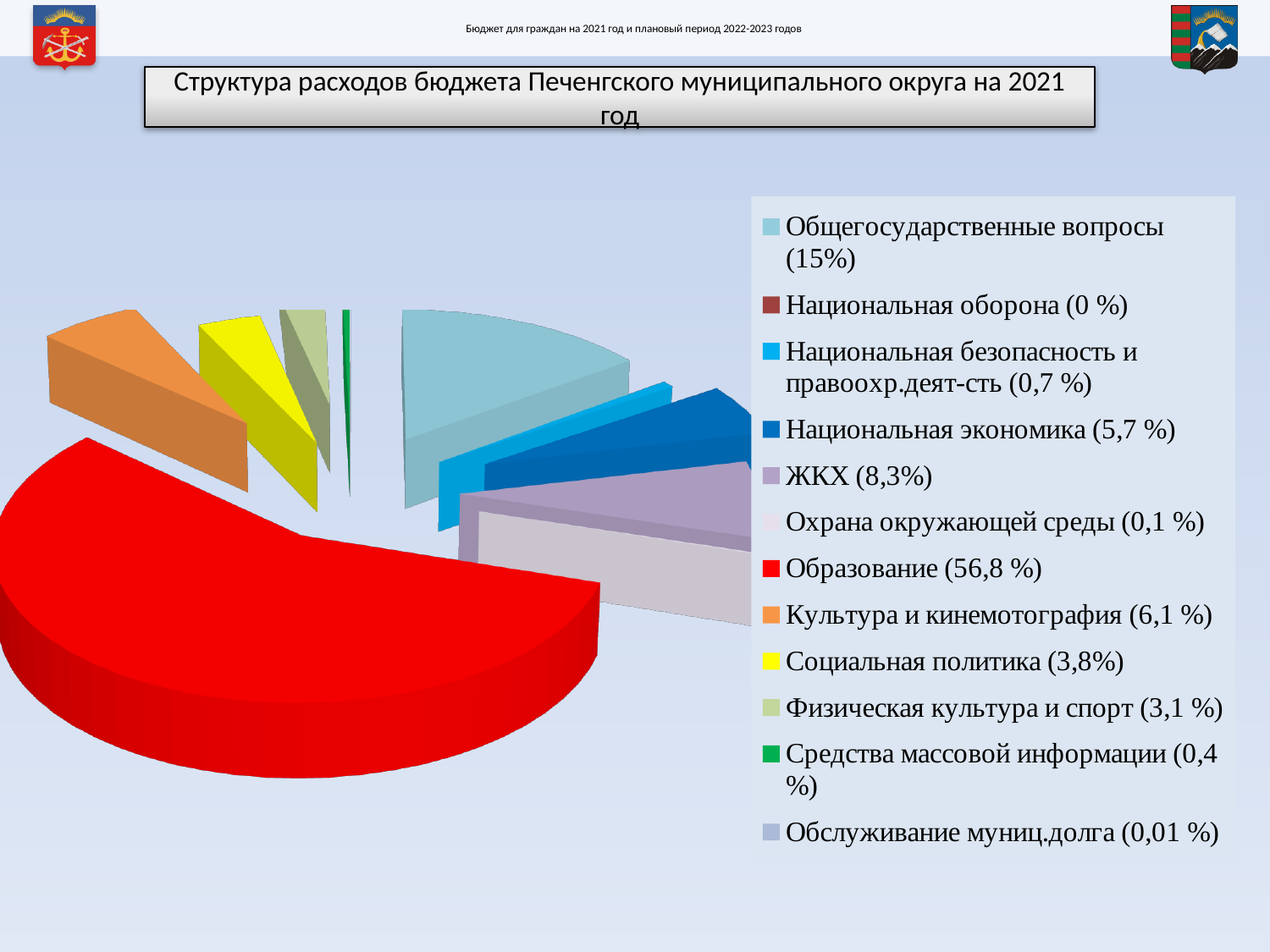
Which is larger: Национальная экономика or Культура и кинемотография? Культура и кинемотография What is the value shown for Общегосударственные вопросы? 15% What is the value shown for Национальная безопасность и правоохр.деят-сть? 0,7 % How many categories does the legend list? 12 Which is larger: Социальная политика or Физическая культура и спорт? Социальная политика What share of the budget expenditure goes to Образование? 56,8 % What is the value shown for Средства массовой информации? 0,4 % What is the title of the chart on the slide? Структура расходов бюджета Печенгского муниципального округа на 2021 год What is the value shown for ЖКХ? 8,3% What kind of chart is shown on the slide? pie chart Which category has the largest share of the pie? Образование What is the difference between the shares of Общегосударственные вопросы and ЖКХ? 6,7%